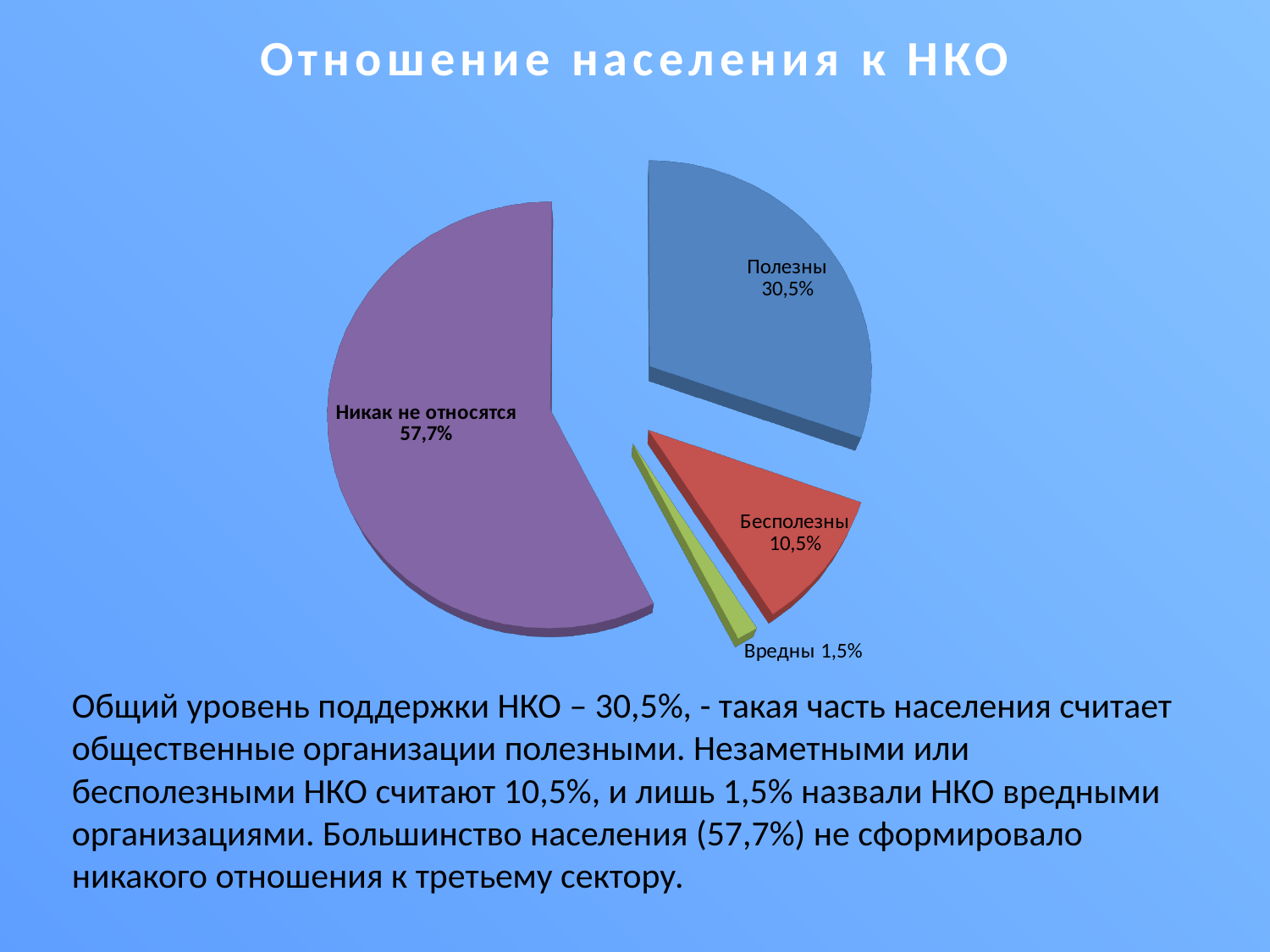
What is the value of the 'Вредны' slice? 1,5% What type of chart is shown on the slide? Pie chart What is the difference between the 'Полезны' and 'Бесполезны' shares? 20 percentage points Which category has the largest share of the pie? Никак не относятся What colour is the 'Никак не относятся' slice? Purple Which is larger, the share for 'Полезны' or the share for 'Бесполезны'? Полезны How many slices does the pie chart have? 4 What percentage is shown for 'Бесполезны'? 10,5% What is the title of the slide containing the chart? Отношение населения к НКО Which category has the smallest share of the pie? Вредны What share of the population considers NGOs useful (Полезны)? 30,5% What is the value for the slice labelled 'Никак не относятся'? 57,7%